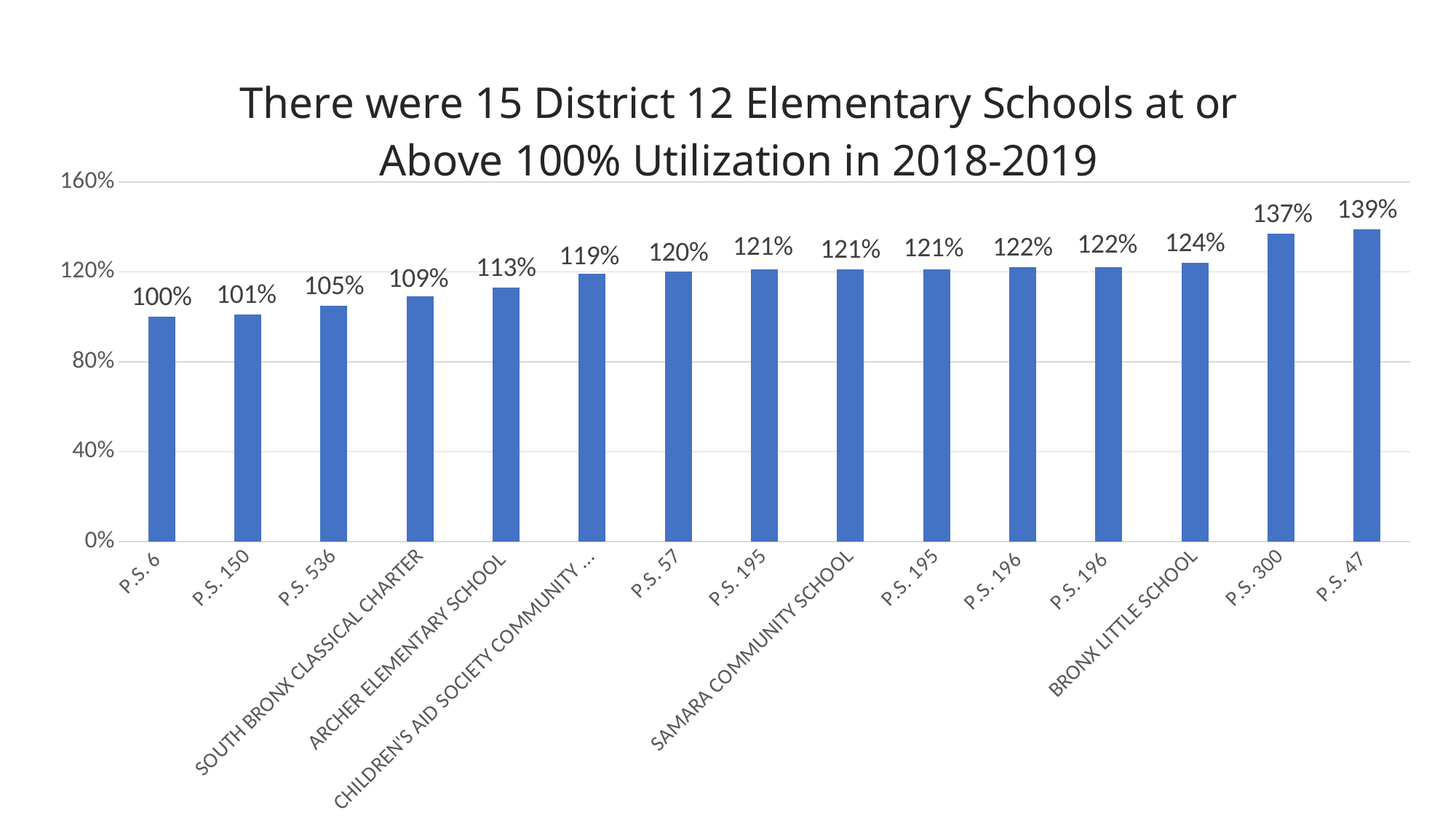
What is the utilization value for P.S. 6? 100% What is the difference in utilization between Bronx Little School and P.S. 536? 19% What is the utilization value for Bronx Little School? 124% How many schools are shown in the chart? 15 Do the values rise or fall from left to right along the x axis? Rise What kind of chart is shown on the slide? Bar chart Which school has the highest utilization? P.S. 47 What is the difference in utilization between P.S. 47 and P.S. 300? 2% Which school has the lowest utilization? P.S. 6 What is the utilization value for Archer Elementary School? 113% What is the utilization value for South Bronx Classical Charter? 109% Which has a higher utilization, P.S. 57 or P.S. 150? P.S. 57